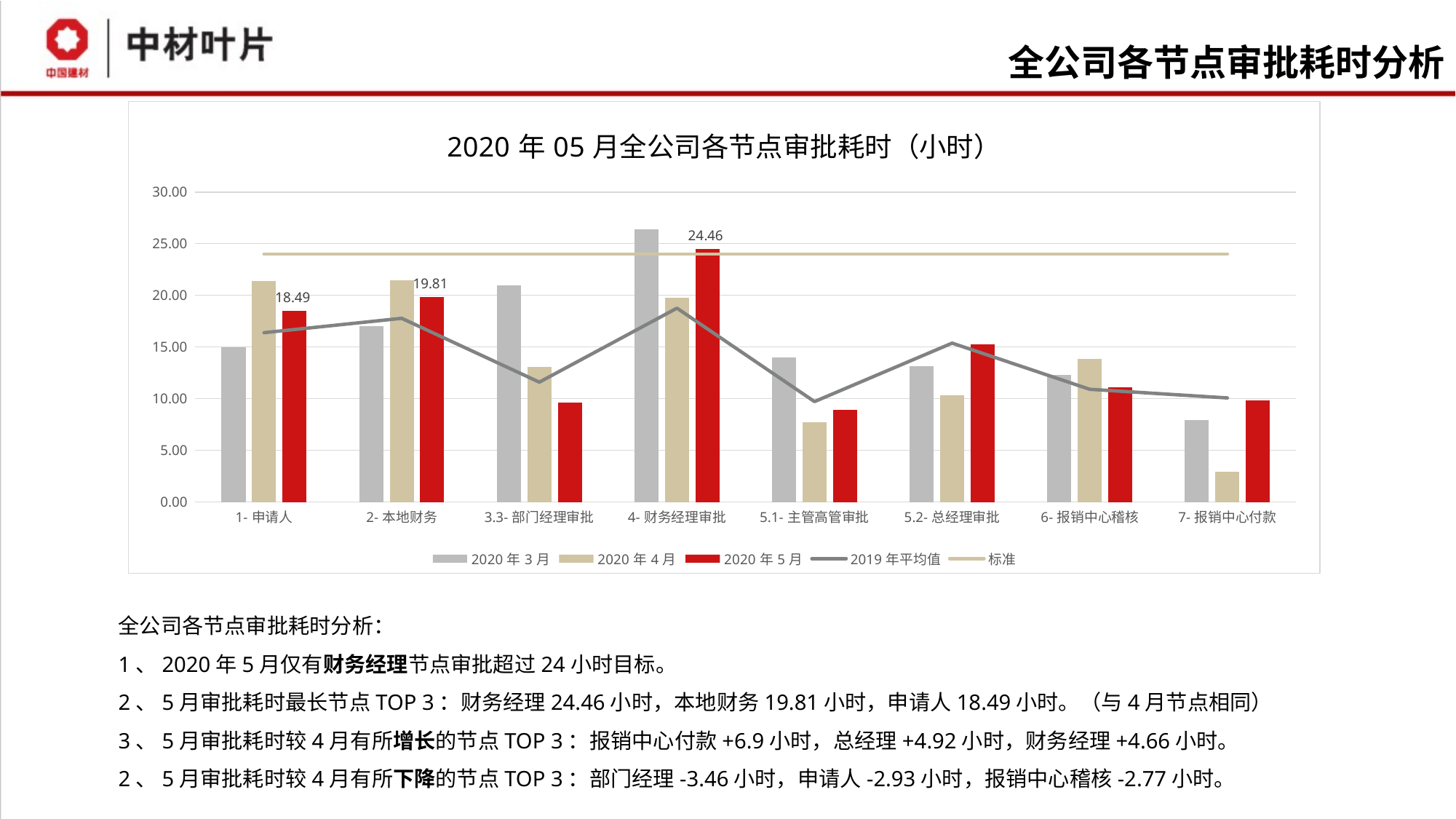
What is the 2020年5月 value for 2-本地财务? 19.81 What is the title of the chart? 2020年05月全公司各节点审批耗时（小时） What is the 2020年5月 value for 4-财务经理审批? 24.46 Is the 2020年4月 value for 5.1-主管高管审批 greater or less than 10.00? less What is the 2020年5月 value for 1-申请人? 18.49 Which category has the lowest 2020年4月 bar? 7-报销中心付款 For 4-财务经理审批, which is larger: the 2020年3月 bar or the 2020年5月 bar? 2020年3月 How many series does the legend list? 5 Which category has the highest 2020年5月 bar? 4-财务经理审批 Is the 2020年3月 value for 4-财务经理审批 greater or less than 25.00? greater How many categories are shown on the x axis? 8 What is the difference between the 2020年5月 values for 4-财务经理审批 and 2-本地财务? 4.65